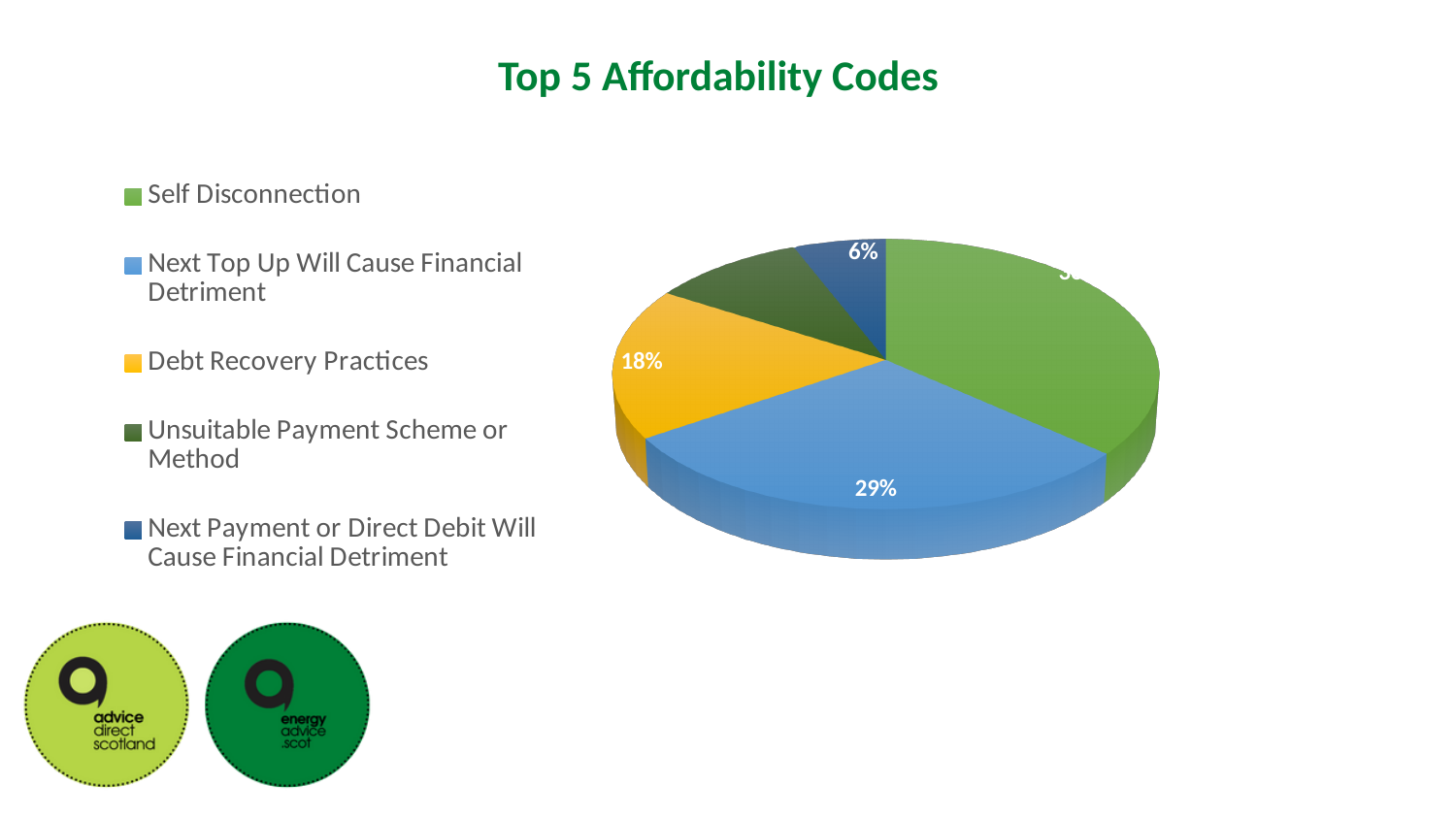
Which category has the smallest slice of the pie? Next Payment or Direct Debit Will Cause Financial Detriment What kind of chart is shown on the slide? pie chart What is the difference in percentage points between Next Top Up Will Cause Financial Detriment and Debt Recovery Practices? 11 What is the difference in percentage points between Debt Recovery Practices and Next Payment or Direct Debit Will Cause Financial Detriment? 12 What share of the pie is Debt Recovery Practices? 18% Which category has the largest slice of the pie? Self Disconnection What is the title of the chart? Top 5 Affordability Codes How many categories does the pie chart have? 5 Which is larger: Next Top Up Will Cause Financial Detriment or Debt Recovery Practices? Next Top Up Will Cause Financial Detriment What share of the pie is Next Payment or Direct Debit Will Cause Financial Detriment? 6% What share of the pie is Next Top Up Will Cause Financial Detriment? 29% What colour is the Debt Recovery Practices slice? yellow